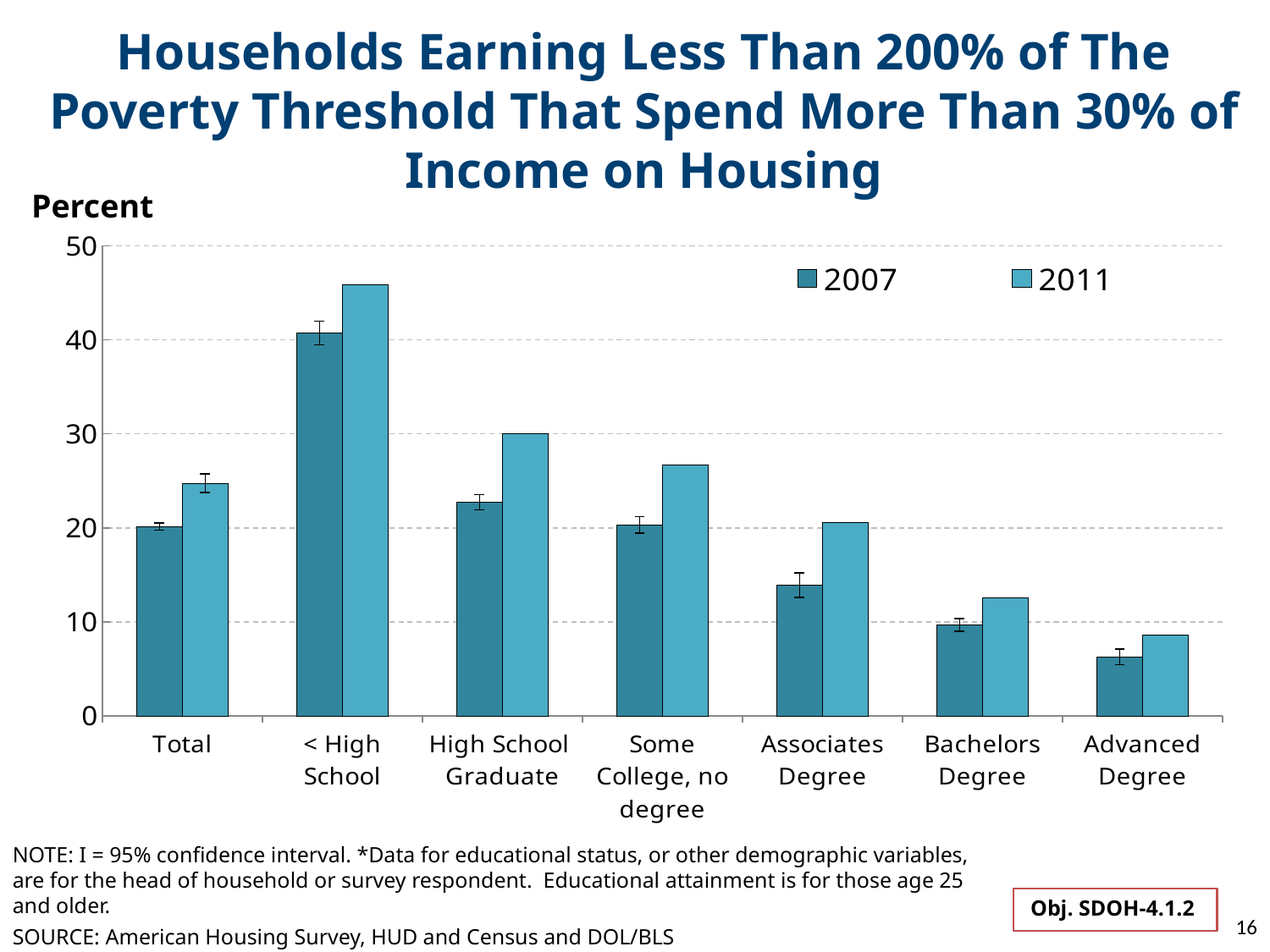
Is the 2007 value for Associates Degree greater or less than 20? less For the Total category, which year has the larger value, 2007 or 2011? 2011 Which category has the lowest value for 2007? Advanced Degree What label is shown on the vertical axis of the chart? Percent Which category has the highest value for 2011? < High School Moving from High School Graduate to Advanced Degree along the x axis, do the 2011 values rise or fall? fall How many education categories are shown on the x axis? 7 What kind of chart is shown on the slide? bar chart Is the 2007 value for Advanced Degree greater or less than 10? less How many series does the legend list? 2 Is the 2011 value for Some College, no degree greater or less than 20? greater